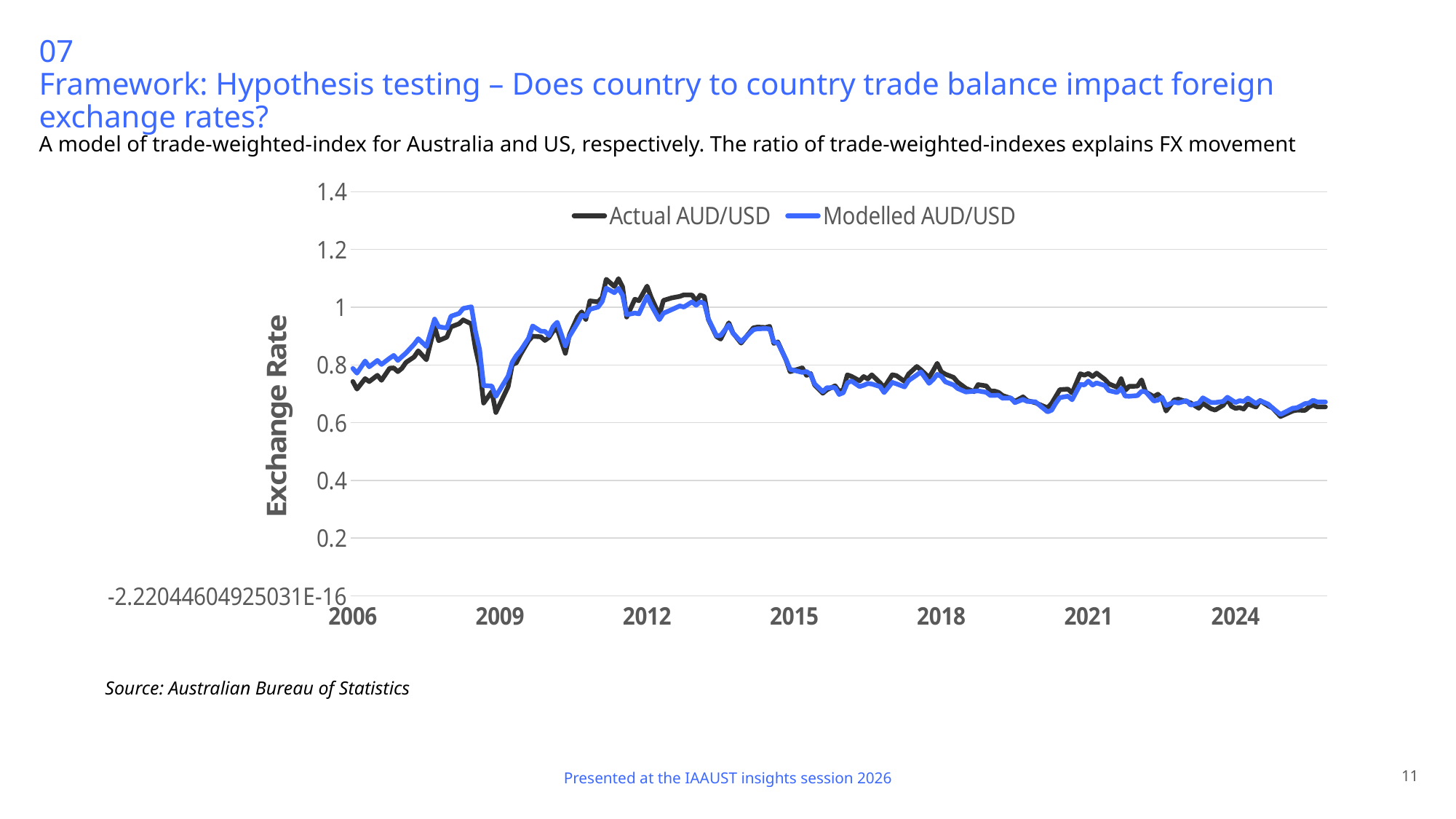
Is the value of Modelled AUD/USD in 2012 greater or less than 0.8? greater Do the Actual AUD/USD values rise or fall between 2009 and 2011? rise Do the Actual AUD/USD values rise or fall between 2012 and 2015? fall How many series does the chart's legend list? 2 How many year labels are shown on the chart's x axis? 7 Is the value of Actual AUD/USD in 2018 greater or less than 0.6? greater Is the value of Actual AUD/USD in 2024 greater or less than 0.8? less What kind of chart is shown on the slide? line chart What is the label on the chart's vertical axis? Exchange Rate What are the two series named in the chart's legend? Actual AUD/USD and Modelled AUD/USD